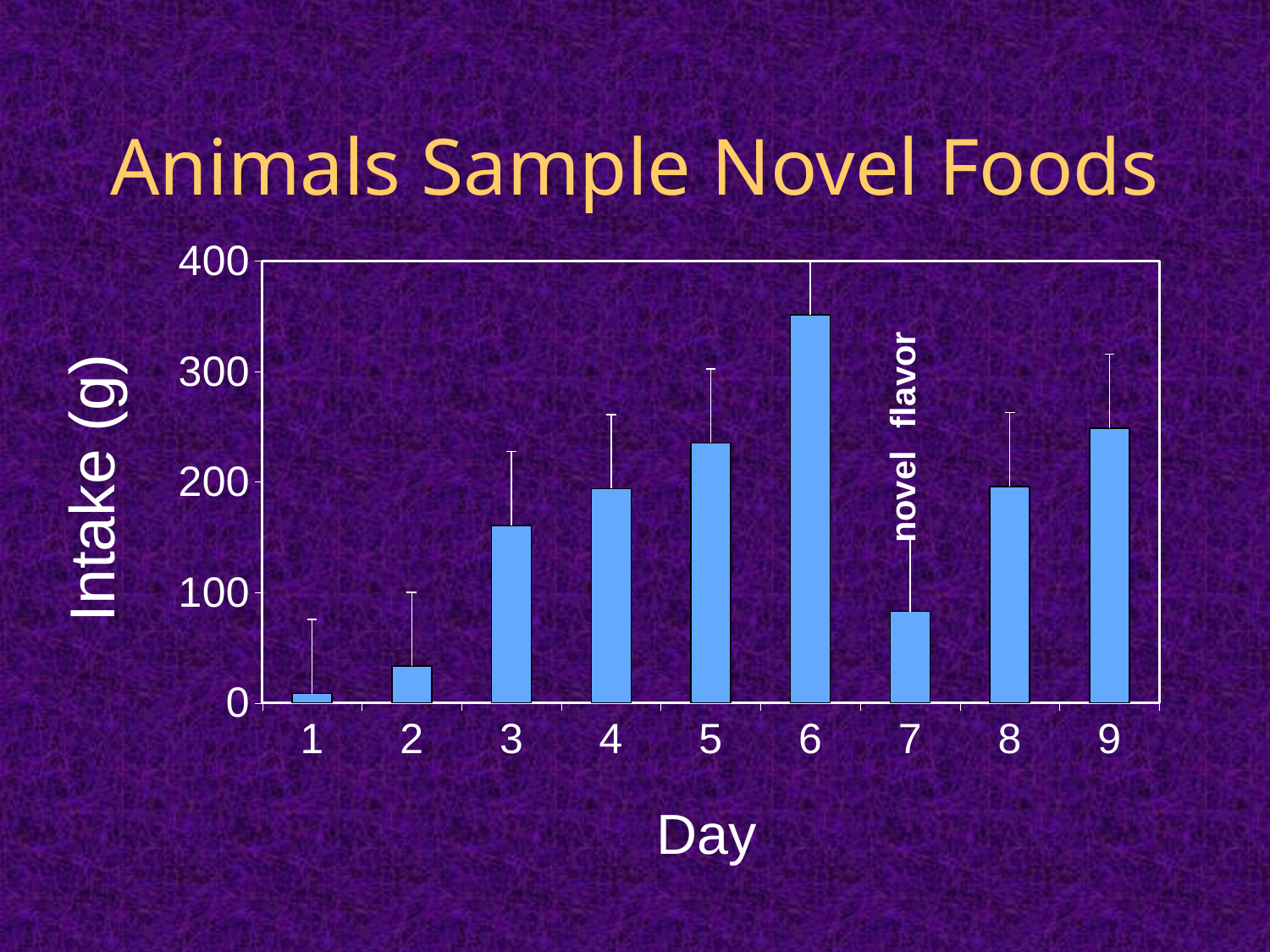
How many days are plotted on the x axis? 9 Which day has the highest intake? 6 Which day has the larger intake, day 3 or day 2? 3 Which day has the lowest intake? 1 Which day's bar is annotated with the label "novel flavor"? 7 Is the intake on day 5 greater or less than 200? greater What kind of chart is shown on the slide? bar chart Does intake rise or fall from day 1 to day 6? rise Is the intake on day 6 greater or less than 300? greater Is the intake on day 2 greater or less than 100? less Which day has the larger intake, day 6 or day 7? 6